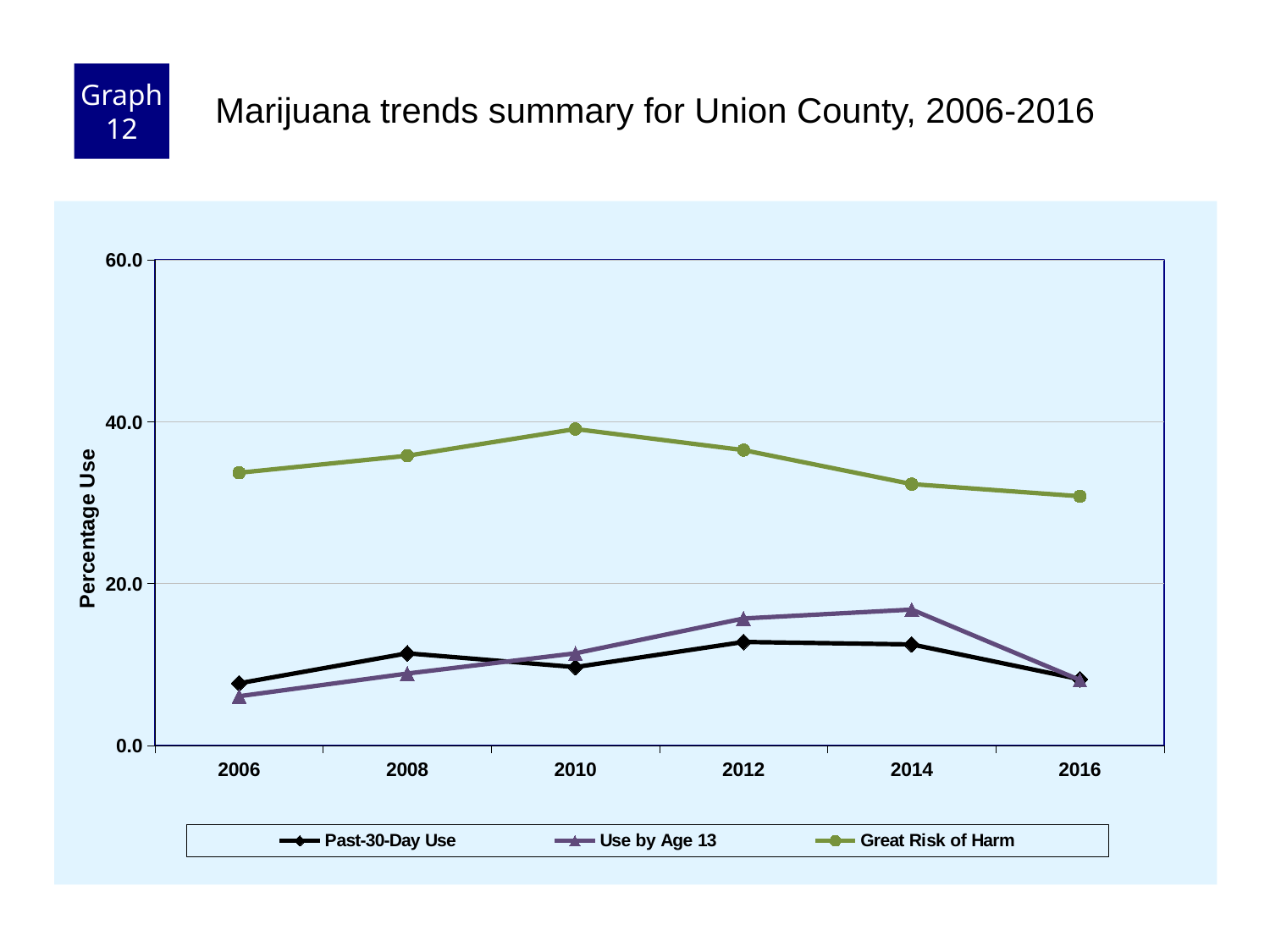
What kind of chart is shown on the slide? Line chart Is the value for Use by Age 13 in 2014 greater or less than 20.0? less What is the label on the y axis? Percentage Use Is the value for Great Risk of Harm in 2016 greater or less than 20.0? greater How many series does the legend list? 3 In 2014, which is larger: Use by Age 13 or Past-30-Day Use? Use by Age 13 Does the Great Risk of Harm series rise or fall from 2010 to 2016? Fall In which year does the Great Risk of Harm series reach its highest value? 2010 In which year is the Use by Age 13 series at its highest? 2014 How many years are plotted along the x axis? 6 In which year is the Use by Age 13 series at its lowest? 2006